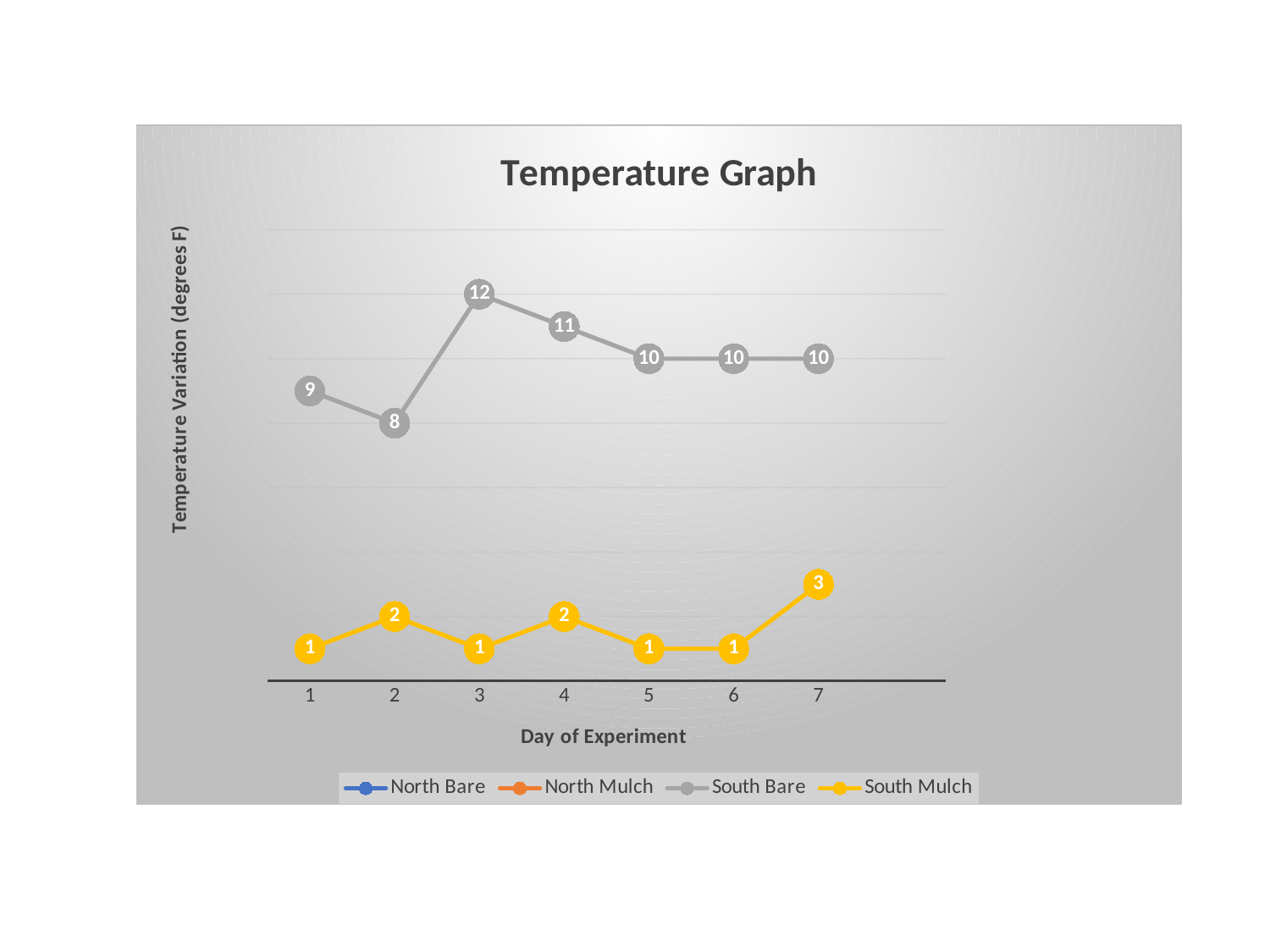
What is the South Mulch value on day 7? 3 What is the South Bare value on day 2? 8 What is the South Bare value on day 3? 12 What is the difference between the South Bare and South Mulch values on day 3? 11 What type of chart is shown on the slide? line chart How many days are shown on the x axis? 7 What is the title of the chart? Temperature Graph Which series has the larger value on day 5, South Bare or South Mulch? South Bare On which day is the South Bare value highest? 3 On which day is the South Bare value lowest? 2 What is the label of the x axis? Day of Experiment How many series does the legend list? 4